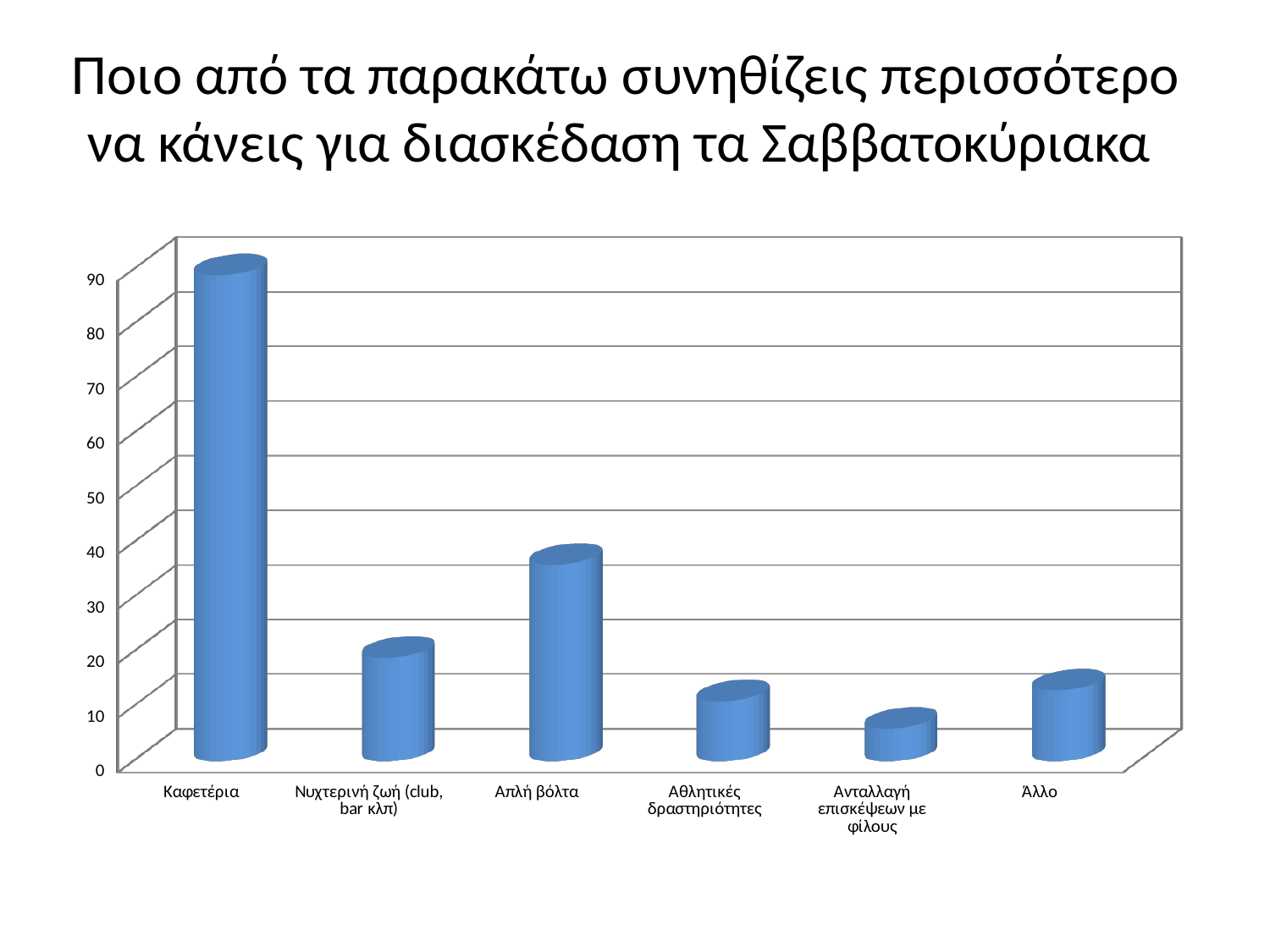
Which is larger, the value for Απλή βόλτα or the value for Νυχτερινή ζωή (club, bar κλπ)? Απλή βόλτα Which category has the lowest value in the chart? Ανταλλαγή επισκέψεων με φίλους Is the value for Απλή βόλτα greater or less than 30? greater What is the highest tick value shown on the vertical axis of the chart? 90 Is the value for Άλλο greater or less than 20? less Is the value for Αθλητικές δραστηριότητες greater or less than 20? less Which category has the highest value in the chart? Καφετέρια What kind of chart is shown on the slide? bar chart Which is larger, the value for Καφετέρια or the value for Απλή βόλτα? Καφετέρια How many categories are shown on the x axis of the chart? 6